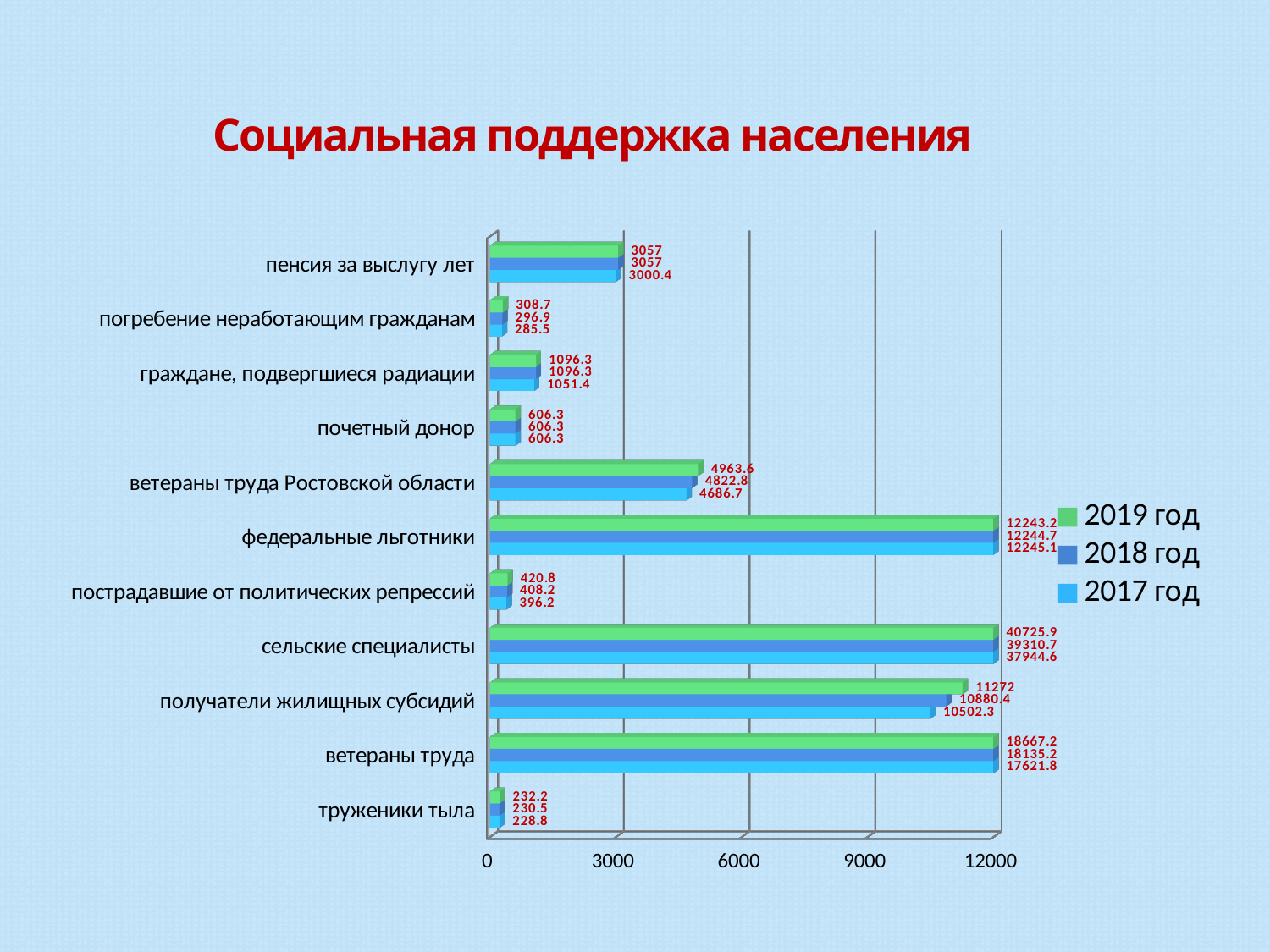
Which is larger: the 2019 год value for ветераны труда Ростовской области or the 2019 год value for пенсия за выслугу лет? ветераны труда Ростовской области What is the difference between the 2019 год and 2017 год values for ветераны труда? 1045.4 What is the value for труженики тыла in 2019 год? 232.2 Which category has the lowest value in 2017 год? труженики тыла What kind of chart is shown on the slide? bar chart What is the value for получатели жилищных субсидий in 2018 год? 10880.4 Which category has the highest value in 2019 год? сельские специалисты What is the value for сельские специалисты in 2019 год? 40725.9 What is the difference between the 2019 год and 2018 год values for получатели жилищных субсидий? 391.6 What is the value for ветераны труда in 2017 год? 17621.8 How many series does the legend list? 3 How many categories are shown on the chart? 11